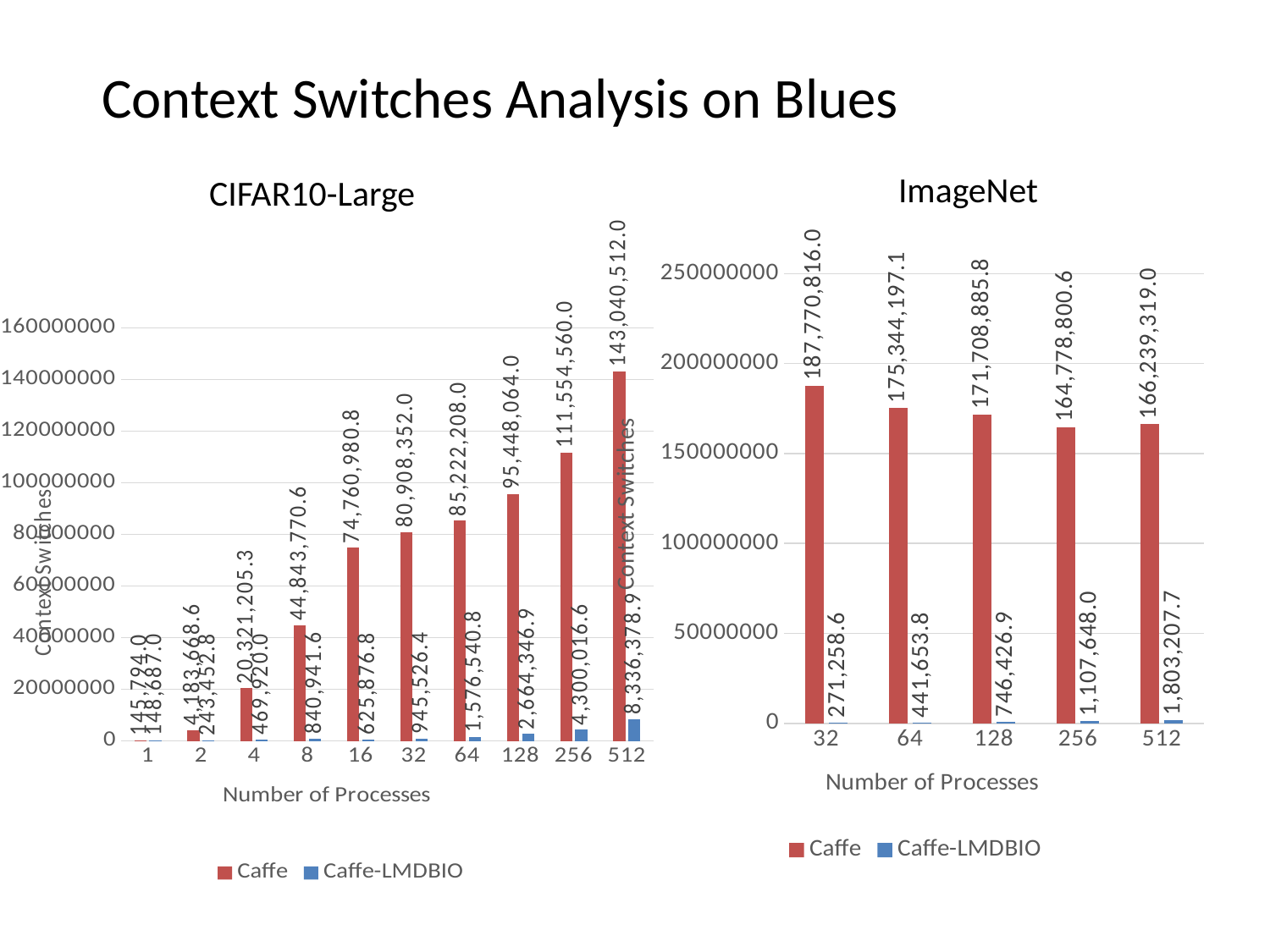
In the ImageNet chart, what is the Caffe value at 32 processes? 187,770,816.0 In the CIFAR10-Large chart, what is the Caffe-LMDBIO value at 256 processes? 4,300,016.6 What type of chart is the ImageNet chart? Bar chart In the CIFAR10-Large chart, which is larger: the Caffe-LMDBIO value at 8 processes or at 16 processes? 8 processes In the CIFAR10-Large chart, at which number of processes is the Caffe value highest? 512 How many series does the legend of the CIFAR10-Large chart list? 2 How many process counts are shown on the x axis of the ImageNet chart? 5 In the CIFAR10-Large chart, is the Caffe value at 128 processes greater or less than 100000000? less In the CIFAR10-Large chart, what is the Caffe value at 512 processes? 143,040,512.0 In the ImageNet chart, what is the Caffe-LMDBIO value at 512 processes? 1,803,207.7 In the ImageNet chart, at which number of processes is the Caffe value lowest? 256 In the ImageNet chart, what is the difference between the Caffe values at 32 and 64 processes? 12,426,618.9